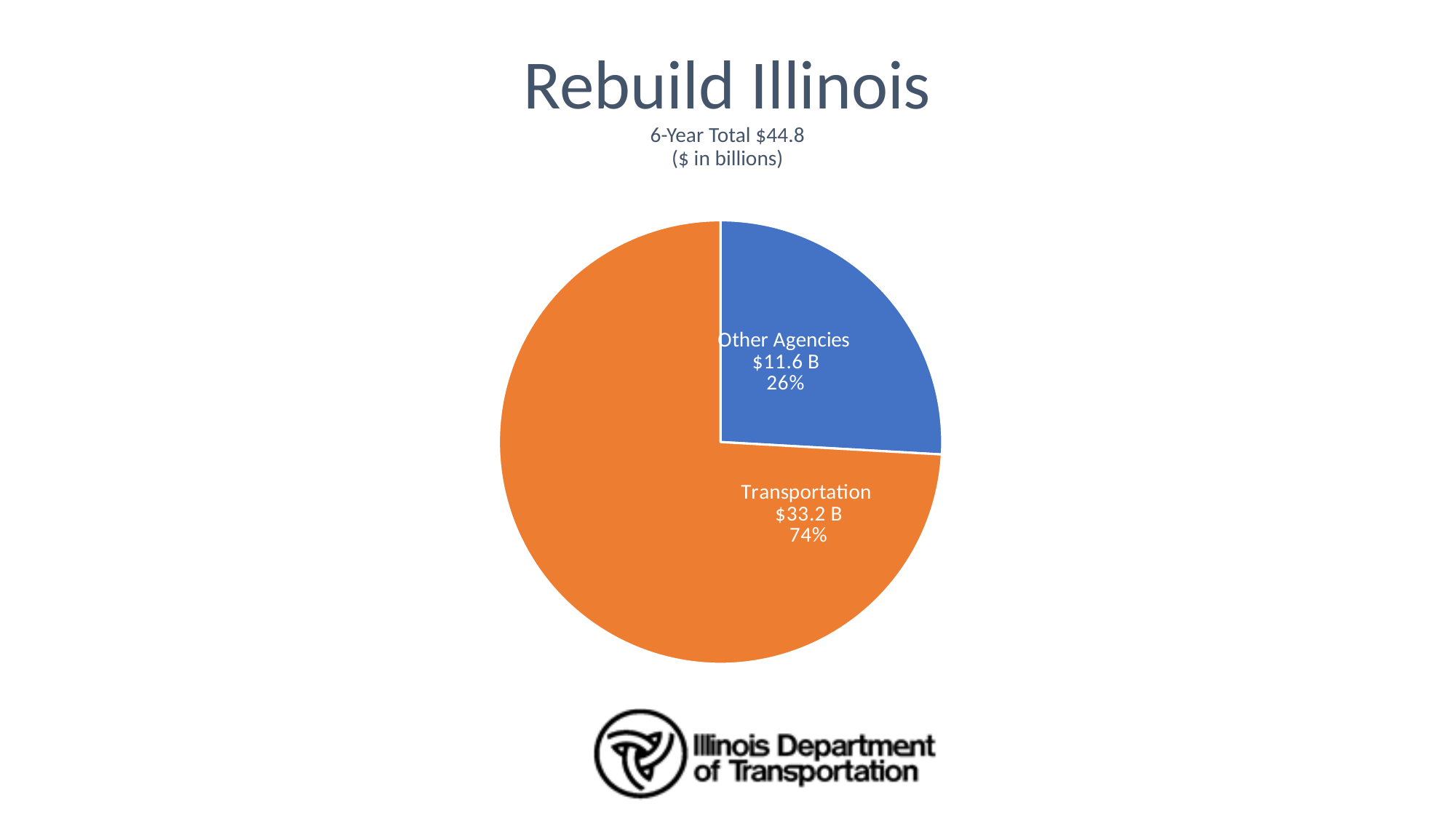
What colour is the Transportation slice? Orange What share of the pie does Transportation represent? 74% Which is larger, Transportation or Other Agencies? Transportation Which slice is the smallest? Other Agencies What share of the pie does Other Agencies represent? 26% What kind of chart is shown on the slide? Pie chart What is the difference in dollars between Transportation and Other Agencies? $21.6 B What is the dollar value for Other Agencies? $11.6 B What is the 6-year total shown on the slide? $44.8 What is the dollar value for Transportation? $33.2 B How many slices does the pie chart have? 2 Which slice is the largest? Transportation